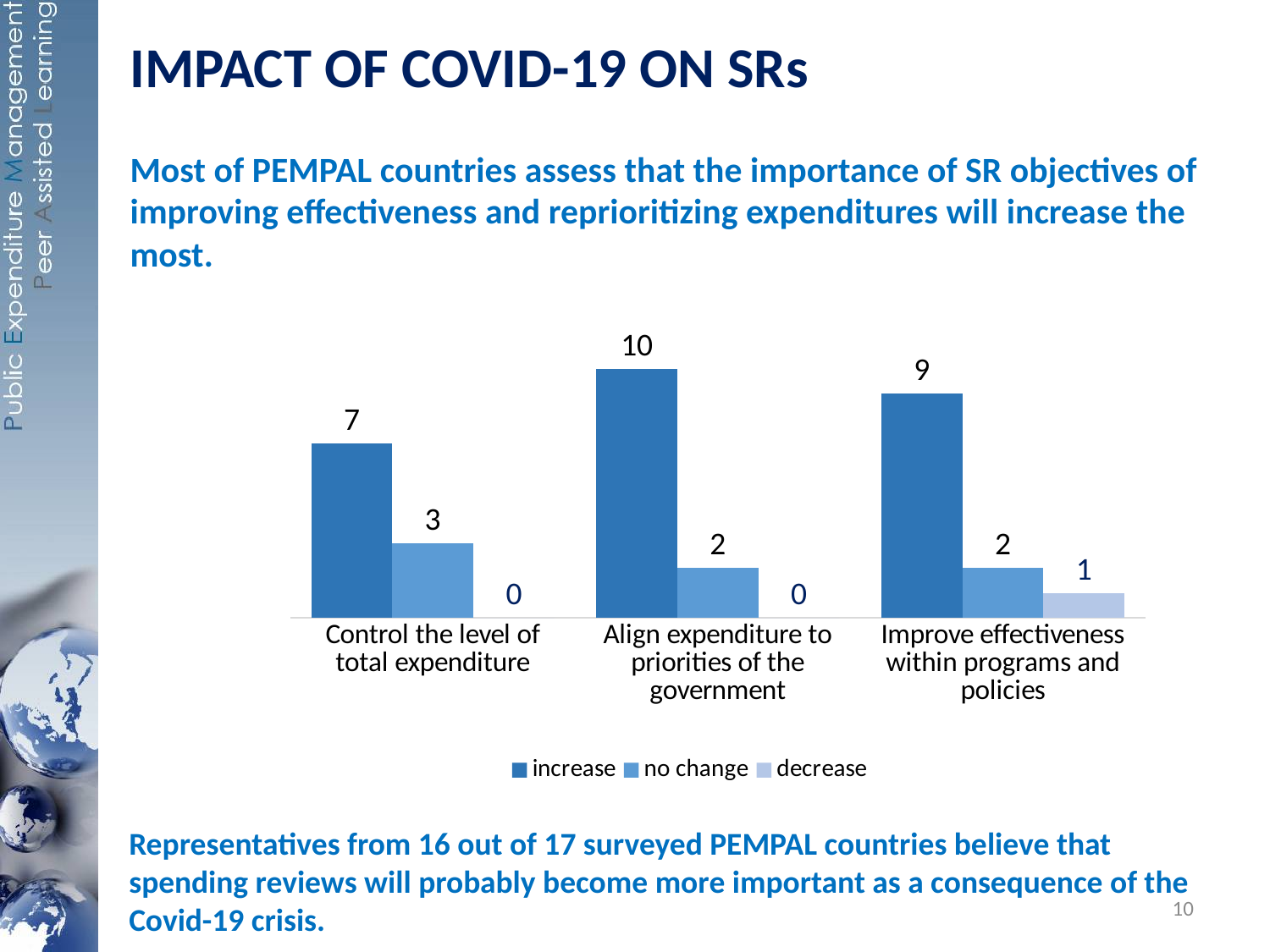
What is the value for "increase" in the "Align expenditure to priorities of the government" category? 10 Which category has the highest "increase" value? Align expenditure to priorities of the government What are the three series named in the chart legend? increase, no change, decrease How many categories are shown on the x axis of the chart? 3 Which category has the lowest "increase" value? Control the level of total expenditure What is the value for "no change" in the "Control the level of total expenditure" category? 3 Which is larger: the "increase" value for "Improve effectiveness within programs and policies" or for "Control the level of total expenditure"? Improve effectiveness within programs and policies What is the difference between the "increase" values for "Align expenditure to priorities of the government" and "Control the level of total expenditure"? 3 What kind of chart is shown on the slide? Bar chart What is the total of the three values for the "Improve effectiveness within programs and policies" category? 12 How many series does the chart legend list? 3 What is the value for "decrease" in the "Improve effectiveness within programs and policies" category? 1